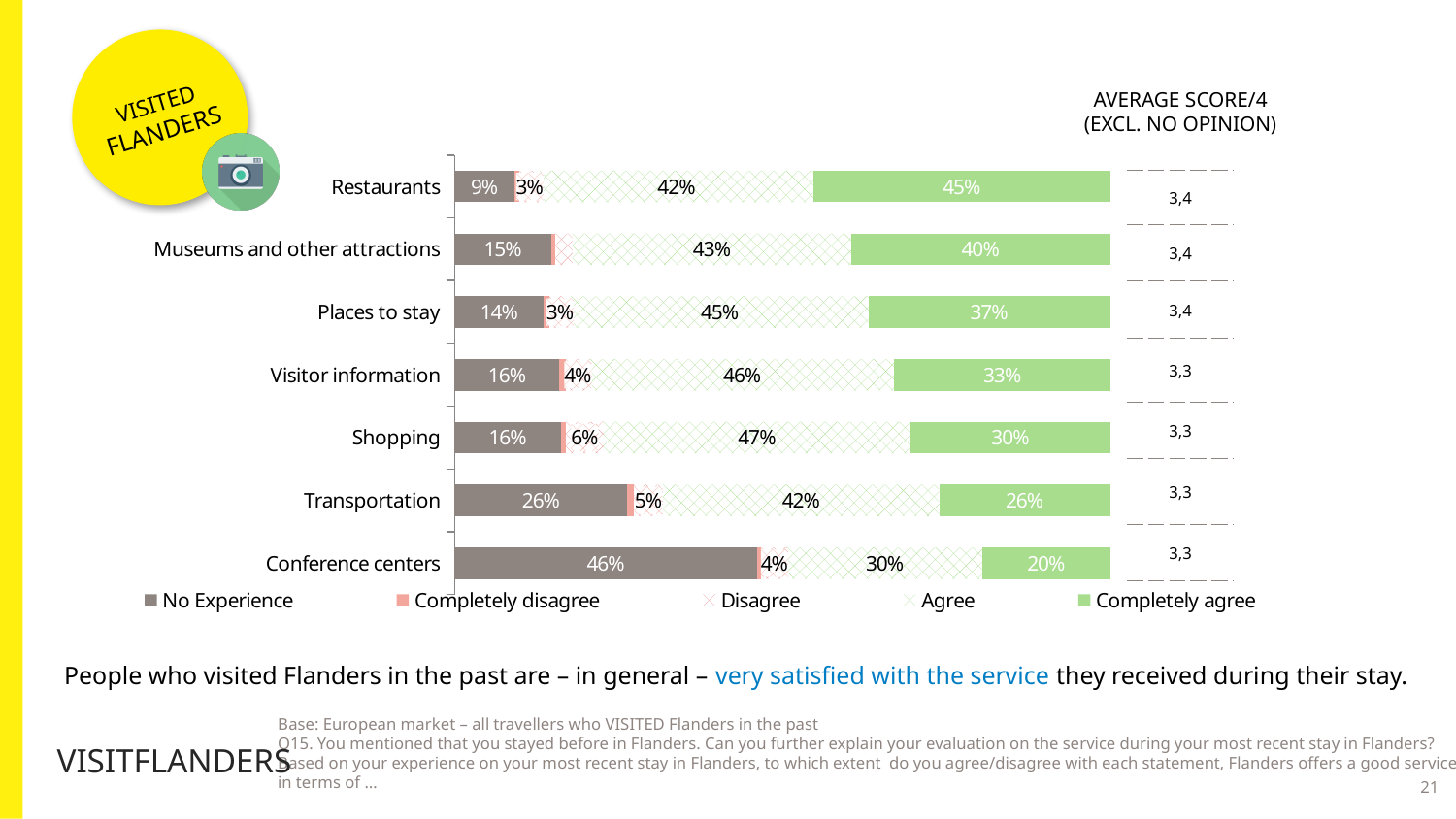
What type of chart is shown on the slide? Stacked bar chart What is the average score (out of 4) shown for Visitor information? 3,3 Which has a larger 'No Experience' share, Transportation or Shopping? Transportation How many categories (service areas) are plotted in the chart? 7 How many series does the legend list? 5 What is the 'No Experience' percentage for Conference centers? 46% What is the 'Completely agree' percentage for Restaurants? 45% What is the title of the column of values shown to the right of the bars? AVERAGE SCORE/4 (EXCL. NO OPINION) Which category has the lowest 'Completely agree' percentage? Conference centers Which category has the highest 'No Experience' percentage? Conference centers What is the difference between the 'Completely agree' percentages for Restaurants and Conference centers? 25% Which category has the highest 'Completely agree' percentage? Restaurants